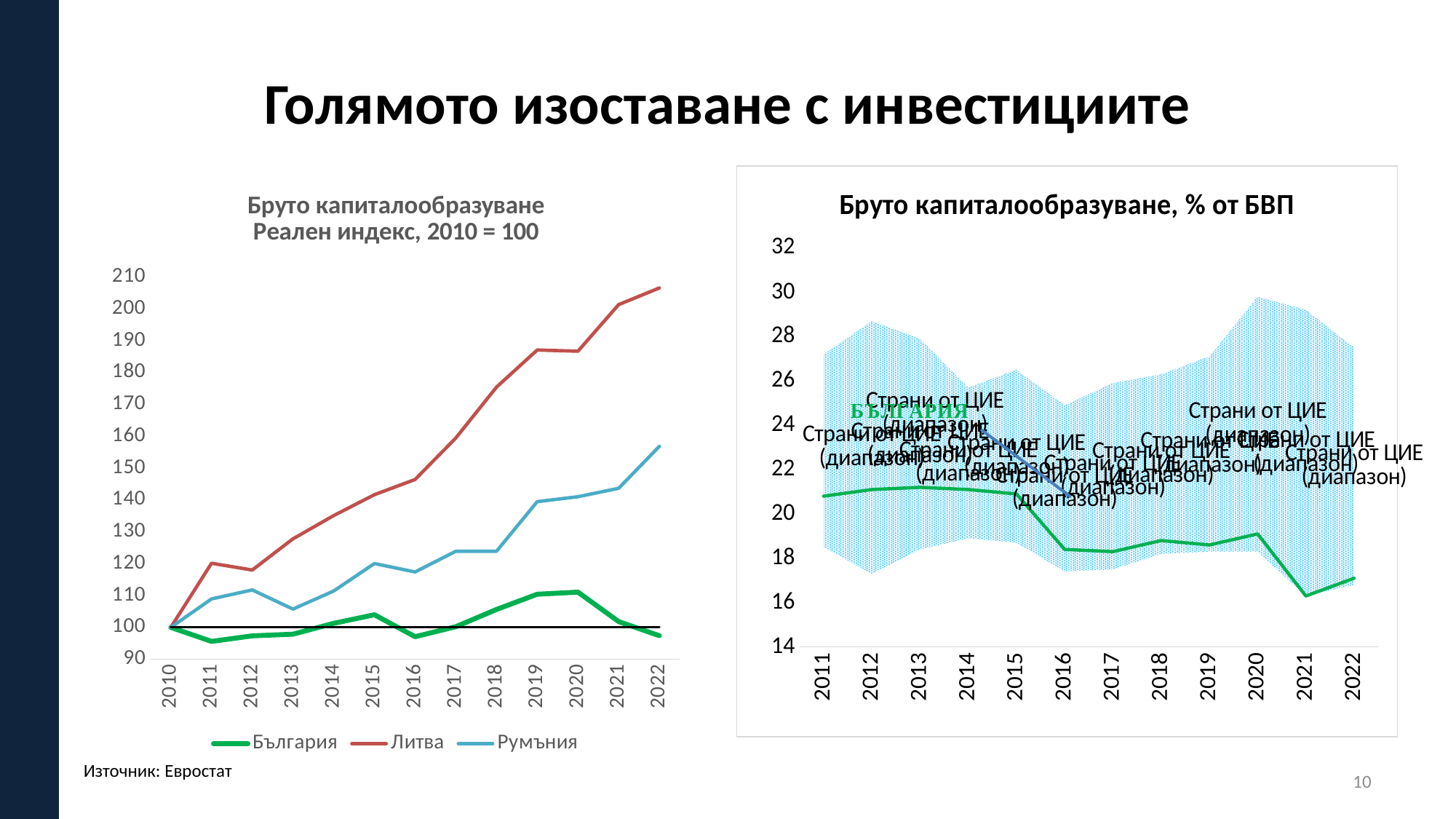
In the right chart (Бруто капиталообразуване, % от БВП), how many years are shown on the x axis? 12 In the left chart (Реален индекс, 2010 = 100), how many series does the legend list? 3 In the left chart (Реален индекс, 2010 = 100), how many years are shown on the x axis? 13 In the right chart (Бруто капиталообразуване, % от БВП), is the value for България in 2021 greater or less than 18? less In the left chart (Реален индекс, 2010 = 100), does the Литва line rise or fall from 2010 to 2022? rise In the left chart (Реален индекс, 2010 = 100), which series has the highest value in 2022? Литва In the left chart (Реален индекс, 2010 = 100), is the value for Литва in 2022 greater or less than 200? greater In the left chart (Реален индекс, 2010 = 100), is the value for България in 2022 greater or less than 100? less In the right chart (Бруто капиталообразуване, % от БВП), does the България line rise or fall from 2011 to 2022? fall In the left chart (Реален индекс, 2010 = 100), which series has the lowest value in 2022? България What kind of chart is the left chart titled "Бруто капиталообразуване Реален индекс, 2010 = 100"? line chart